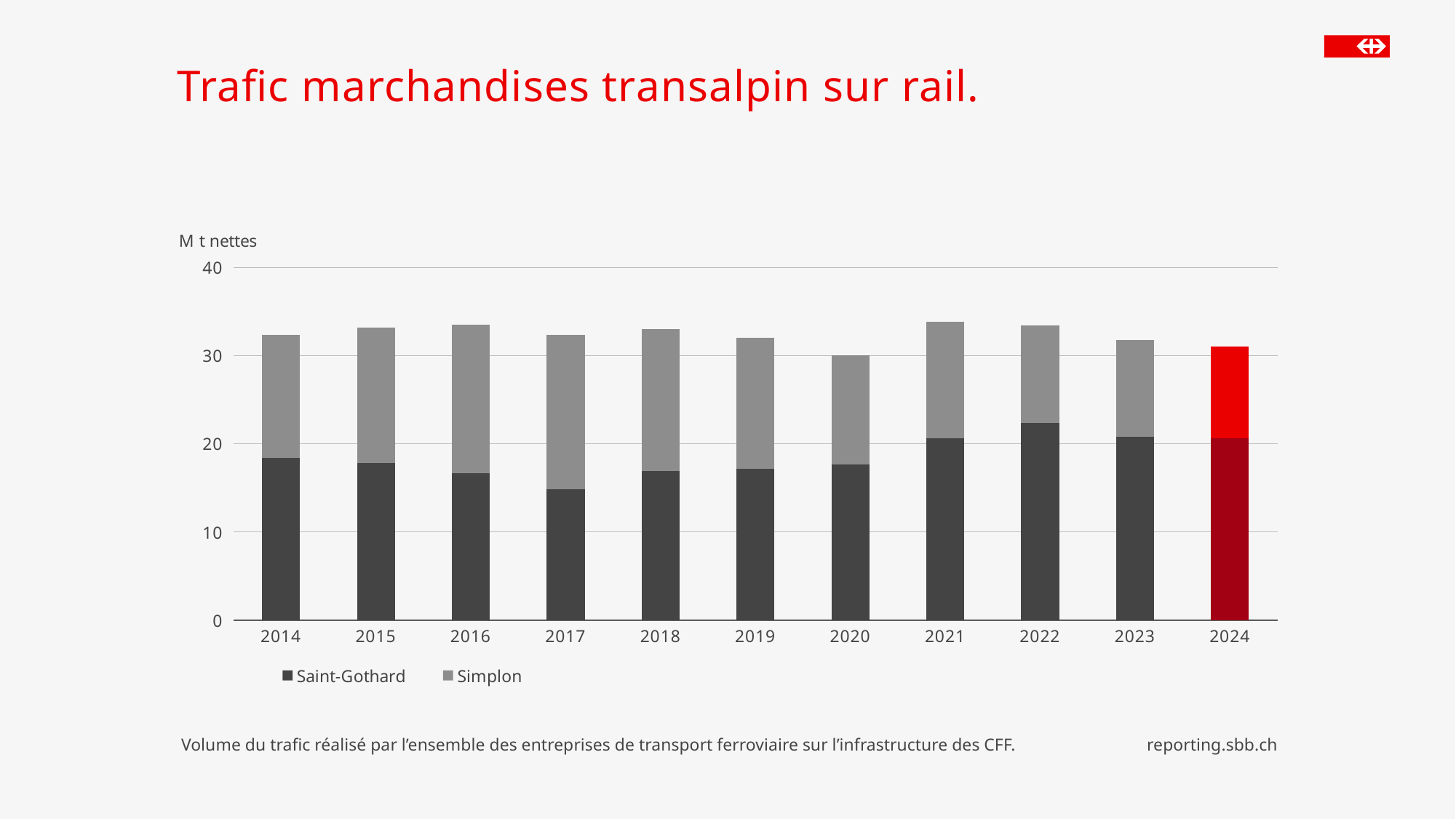
Which is larger, the total bar for 2021 or the total bar for 2020? 2021 What kind of chart is shown on the slide? stacked bar chart In which year is the Saint-Gothard segment the lowest? 2017 Is the Saint-Gothard value for 2017 greater or less than 20? less Does the Saint-Gothard value rise or fall from 2014 to 2017? fall In which year is the Saint-Gothard segment the highest? 2022 Is the Saint-Gothard value for 2022 greater or less than 20? greater Is the total bar for 2014 greater or less than 30? greater What unit is shown above the y axis of the chart? M t nettes Which year has the lowest total transalpine rail freight volume? 2020 How many years are shown on the x axis of the chart? 11 How many series does the chart legend list? 2